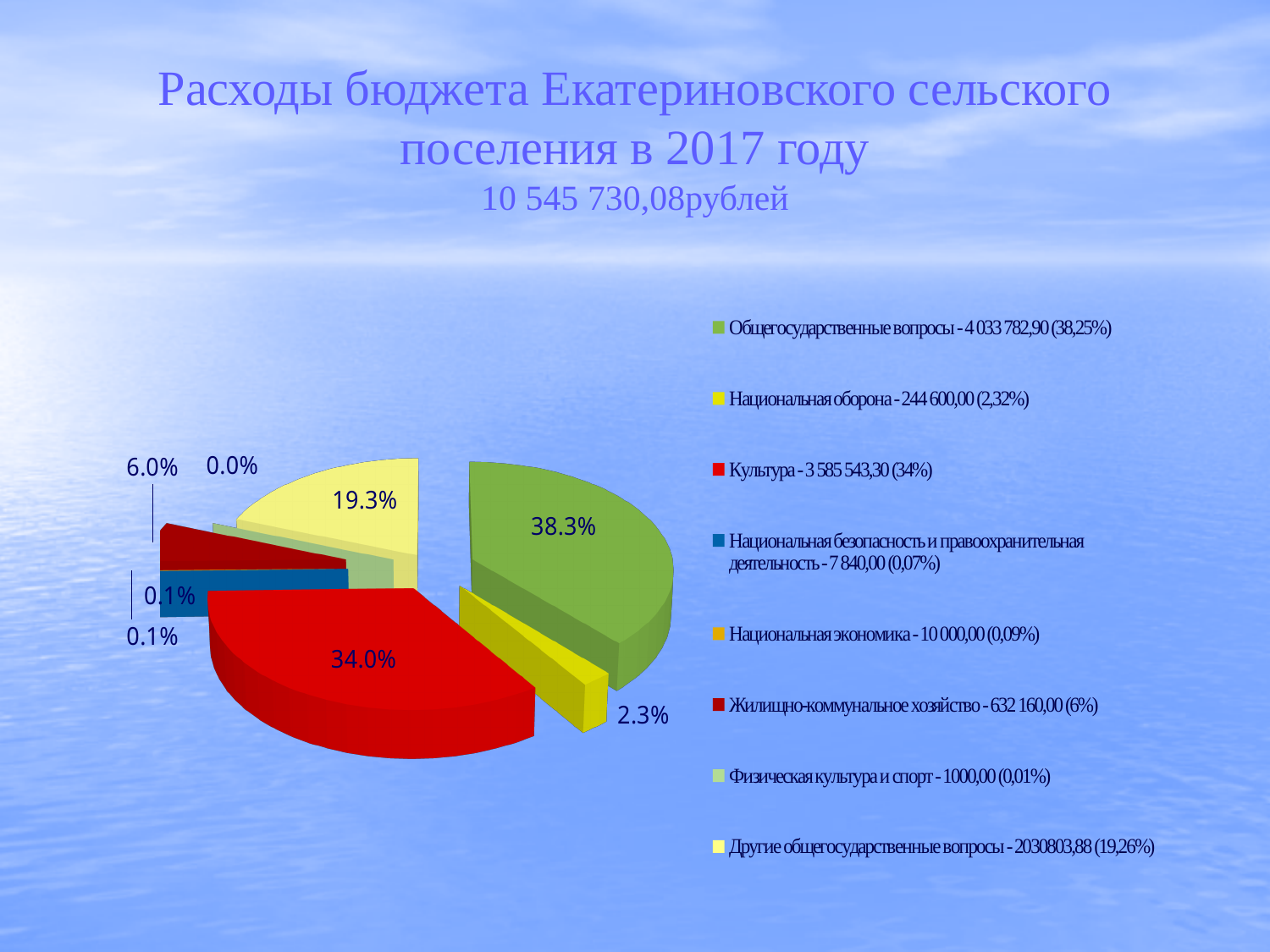
Which category has the smallest slice of the pie chart? Физическая культура и спорт Which slice is larger: Общегосударственные вопросы or Культура? Общегосударственные вопросы How many entries does the legend of the pie chart list? 8 What percentage label is shown on the slice for Другие общегосударственные вопросы? 19.3% What percentage label is shown on the slice for Национальная оборона? 2.3% According to the legend, what amount in rubles is given for Национальная экономика? 10 000,00 What total budget expenditure amount is stated in the slide title? 10 545 730,08 рублей Which category has the largest slice of the pie chart? Общегосударственные вопросы What percentage label is shown on the slice for Культура? 34.0% What kind of chart is shown on the slide? Pie chart What percentage label is shown on the slice for Жилищно-коммунальное хозяйство? 6.0% By how many percentage points does the Общегосударственные вопросы slice (38.3%) exceed the Культура slice (34.0%)? 4.3 percentage points